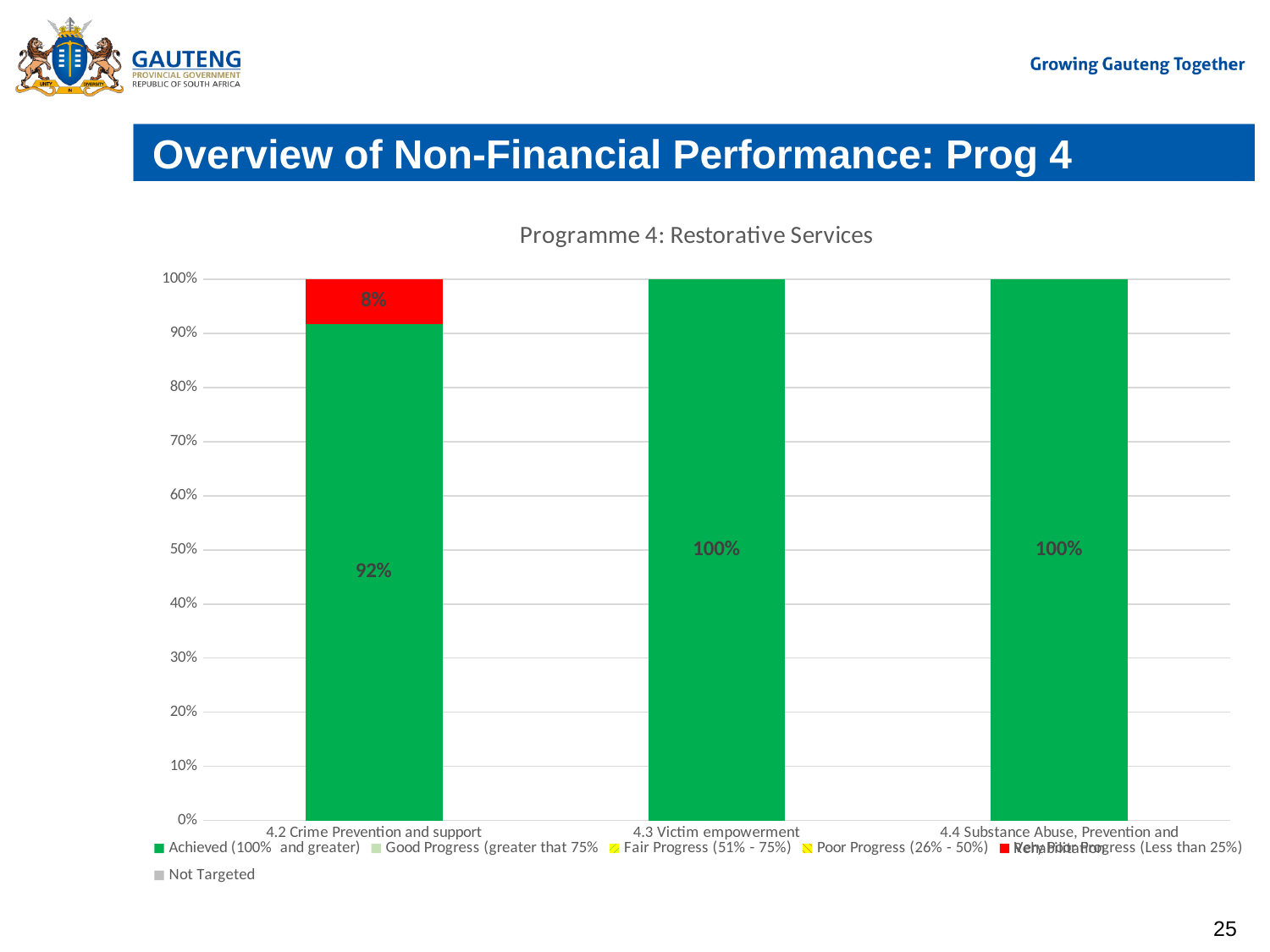
What is the title of the chart? Programme 4: Restorative Services Which has the larger Achieved value, 4.2 Crime Prevention and support or 4.3 Victim empowerment? 4.3 Victim empowerment What kind of chart is shown on the slide? Stacked bar chart How many categories are shown on the x axis? 3 What is the total of the stacked bar for 4.2 Crime Prevention and support? 100% What is the difference between the Achieved value for 4.3 Victim empowerment and the Achieved value for 4.2 Crime Prevention and support? 8% How many series does the legend list? 6 What is the Achieved value for 4.2 Crime Prevention and support? 92% What is the Achieved value for 4.4 Substance Abuse, Prevention and Rehabilitation? 100% What is the Achieved value for 4.3 Victim empowerment? 100% What value is shown for the red segment of the 4.2 Crime Prevention and support bar? 8% Which category has the lowest Achieved value? 4.2 Crime Prevention and support